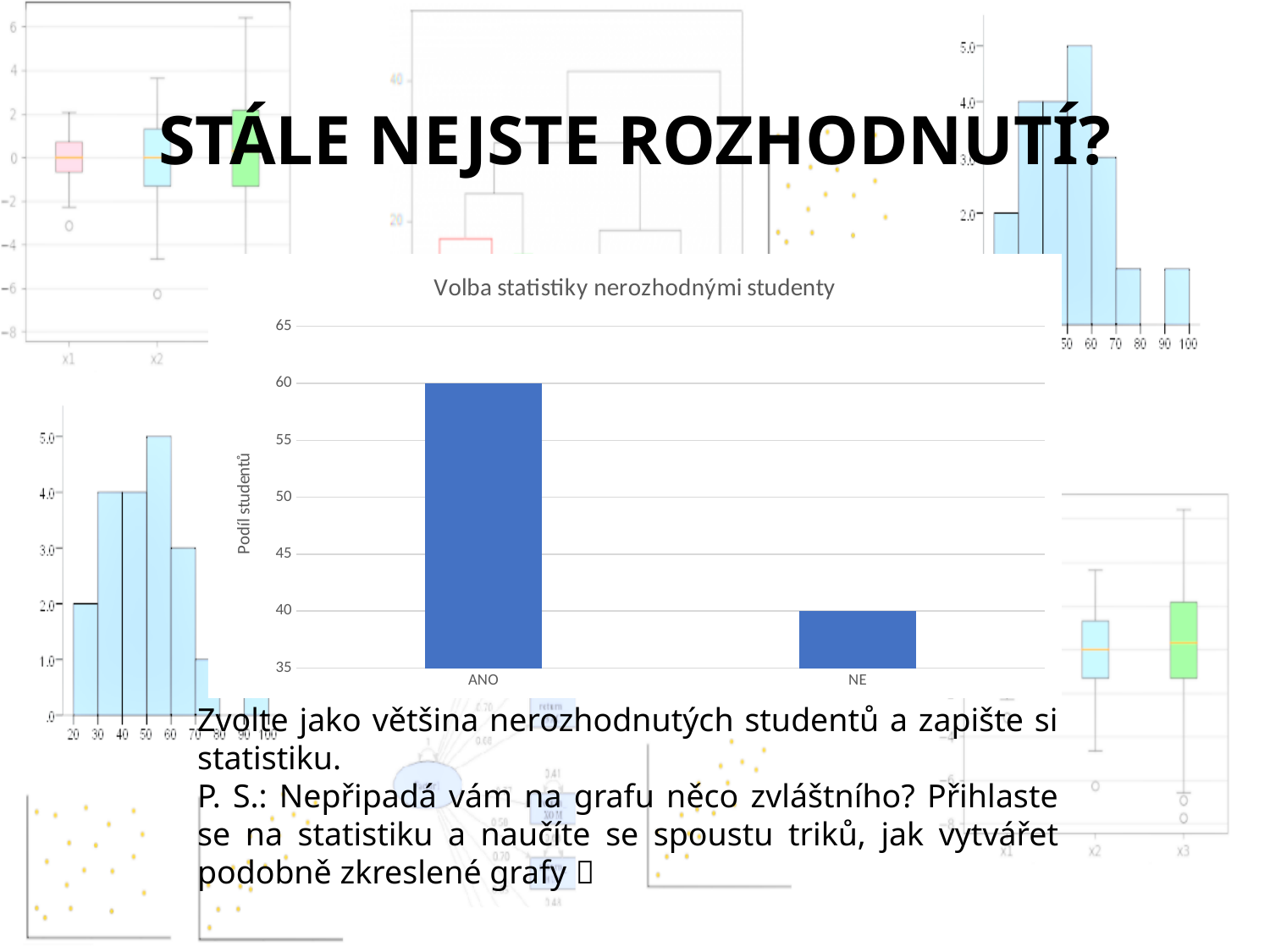
What kind of chart is the one titled 'Volba statistiky nerozhodnými studenty'? bar chart What is the lowest value shown on the vertical axis of the chart titled 'Volba statistiky nerozhodnými studenty'? 35 In the chart titled 'Volba statistiky nerozhodnými studenty', which category has the highest value? ANO In the chart titled 'Volba statistiky nerozhodnými studenty', what is the difference between the values for ANO and NE? 20 In the chart titled 'Volba statistiky nerozhodnými studenty', is the value for ANO greater or less than 55? greater What is the label on the vertical axis of the chart titled 'Volba statistiky nerozhodnými studenty'? Podíl studentů In the chart titled 'Volba statistiky nerozhodnými studenty', is the value for NE greater or less than 50? less In the chart titled 'Volba statistiky nerozhodnými studenty', what is the value for ANO? 60 In the chart titled 'Volba statistiky nerozhodnými studenty', which category has the lowest value? NE In the chart titled 'Volba statistiky nerozhodnými studenty', which is larger, the value for ANO or the value for NE? ANO In the chart titled 'Volba statistiky nerozhodnými studenty', what is the value for NE? 40 How many categories are shown in the chart titled 'Volba statistiky nerozhodnými studenty'? 2